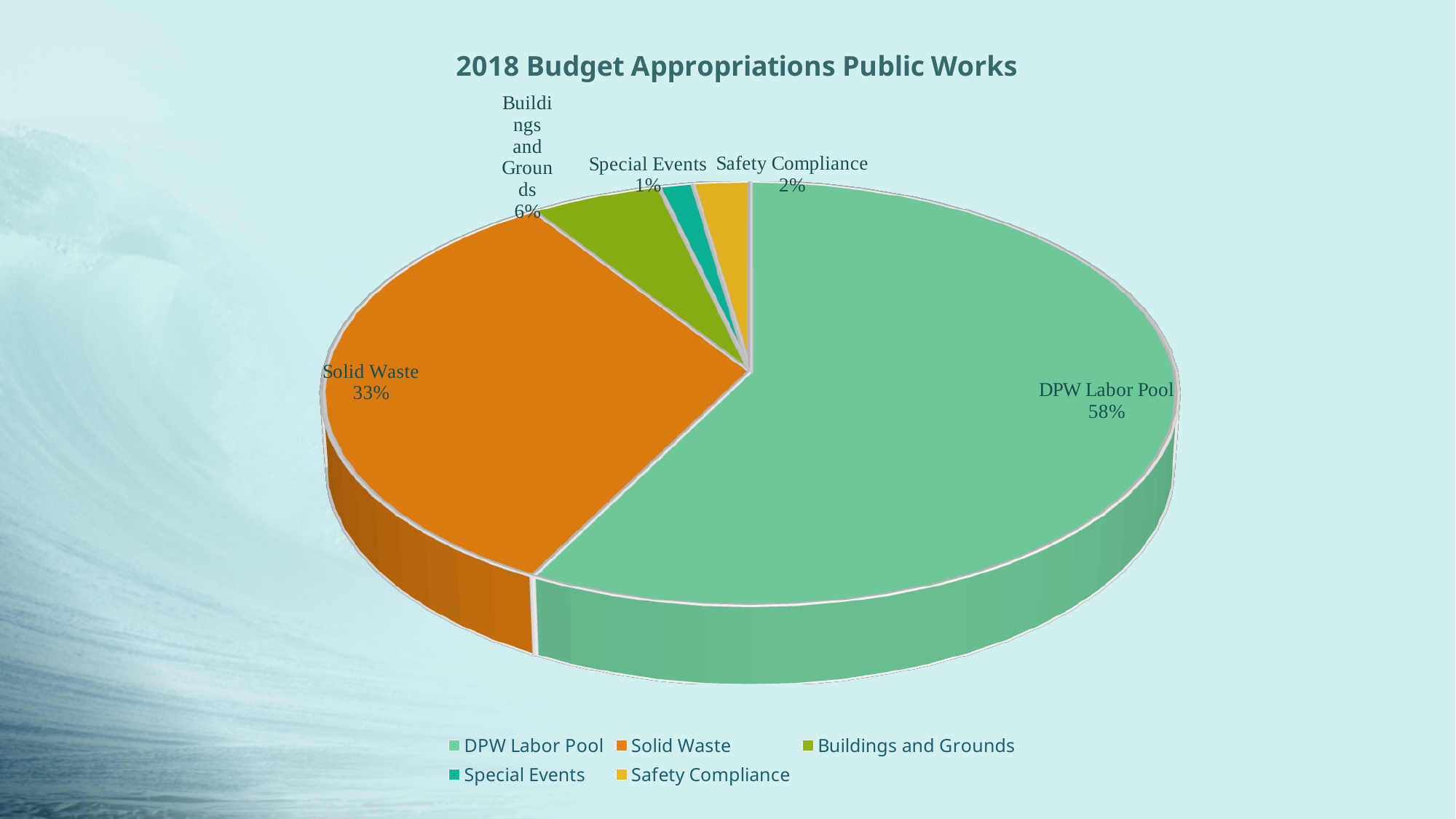
What percentage is shown for Safety Compliance? 2% What percentage is shown for Special Events? 1% How many percentage points larger is DPW Labor Pool than Solid Waste? 25 What is the share for Buildings and Grounds? 6% What share of the 2018 Budget Appropriations Public Works pie is DPW Labor Pool? 58% What is the title of the chart? 2018 Budget Appropriations Public Works Which is larger, Safety Compliance or Special Events? Safety Compliance How many categories does the pie chart show? 5 What kind of chart is shown on the slide? Pie chart Which category has the smallest share of the pie? Special Events Which category has the largest share of the pie? DPW Labor Pool What percentage of the pie does Solid Waste account for? 33%